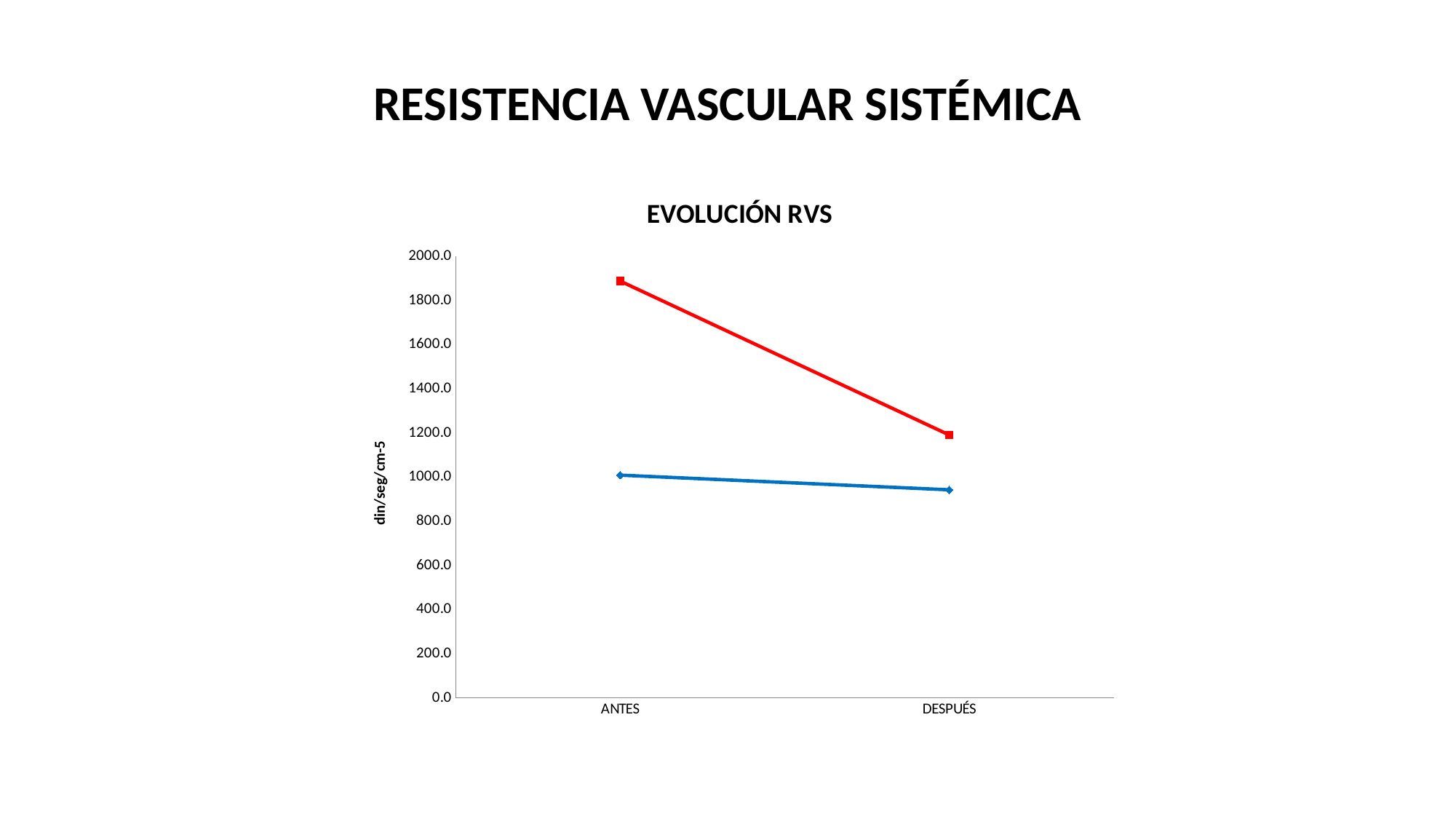
At DESPUÉS, which line has the higher value, the red line or the blue line? the red line What kind of chart is shown on the slide? line chart Does the red line rise or fall from ANTES to DESPUÉS? fall At ANTES, which line has the higher value, the red line or the blue line? the red line Does the blue line rise or fall from ANTES to DESPUÉS? fall What is the label on the vertical axis of the chart? din/seg/cm-5 How many lines are plotted in the chart? 2 Is the value of the blue line at DESPUÉS greater or less than 1000.0? less Is the value of the red line at ANTES greater or less than 1800.0? greater What is the title of the chart? EVOLUCIÓN RVS Is the value of the red line at DESPUÉS greater or less than 1400.0? less How many categories are shown on the x axis of the chart? 2